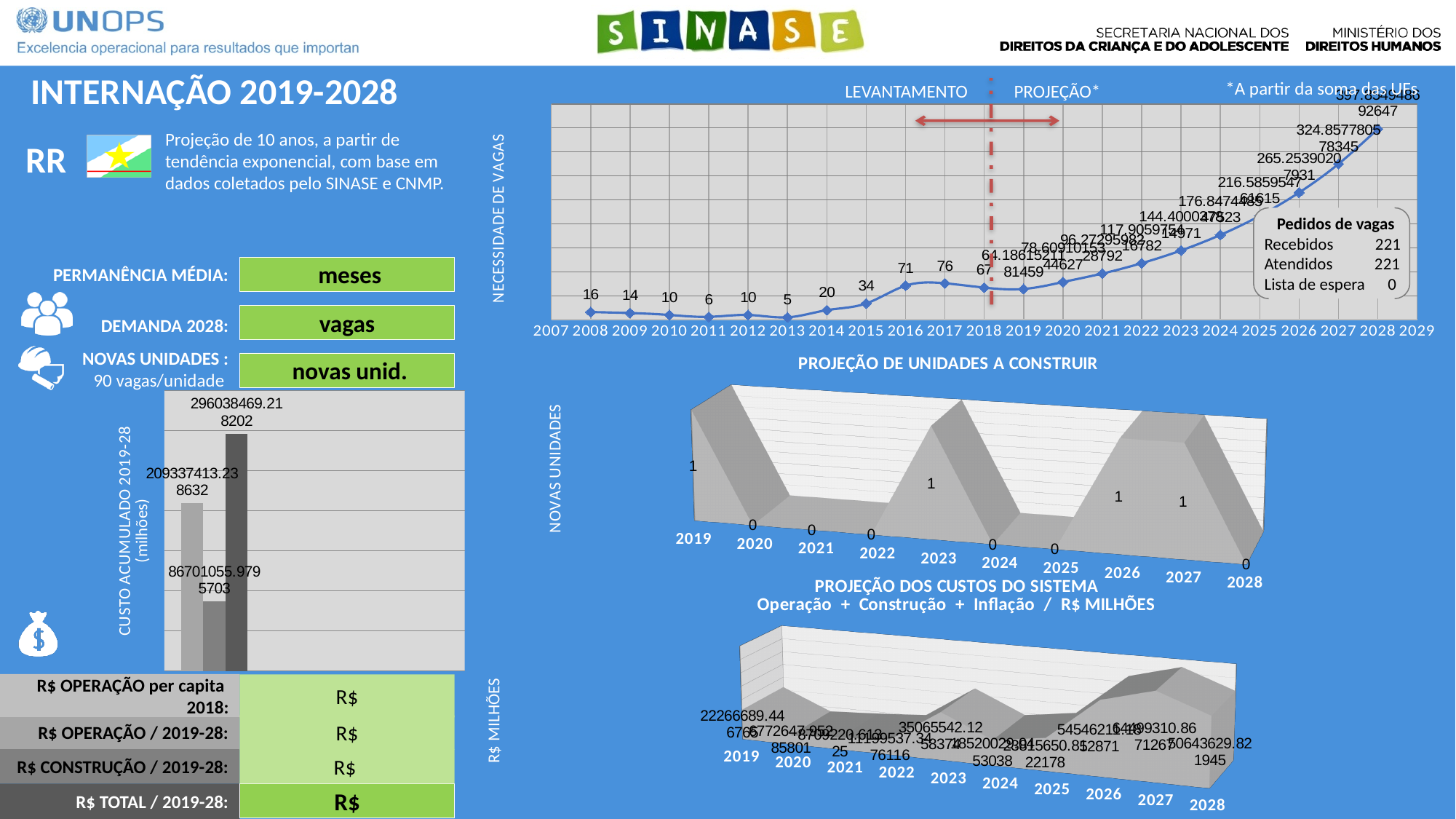
In the PROJEÇÃO DE UNIDADES A CONSTRUIR chart, what is the value for 2023? 1 In the NECESSIDADE DE VAGAS line chart, which year has the lowest value? 2013 How many years are shown on the x axis of the PROJEÇÃO DE UNIDADES A CONSTRUIR chart? 10 In the NECESSIDADE DE VAGAS line chart, which is larger, the value for 2014 or the value for 2015? 2015 What kind of chart is the NECESSIDADE DE VAGAS chart at the top right? line chart In the NECESSIDADE DE VAGAS line chart, what is the value for 2013? 5 In the NECESSIDADE DE VAGAS line chart, what is the value for 2016? 71 In the PROJEÇÃO DE UNIDADES A CONSTRUIR chart, what is the value for 2024? 0 In the NECESSIDADE DE VAGAS line chart, do the values rise or fall from 2019 to 2028? rise How many bars are in the CUSTO ACUMULADO 2019-28 chart on the left of the slide? 3 In the NECESSIDADE DE VAGAS line chart, what is the value for 2018? 67 In the NECESSIDADE DE VAGAS line chart, what is the difference between the values for 2017 and 2016? 5